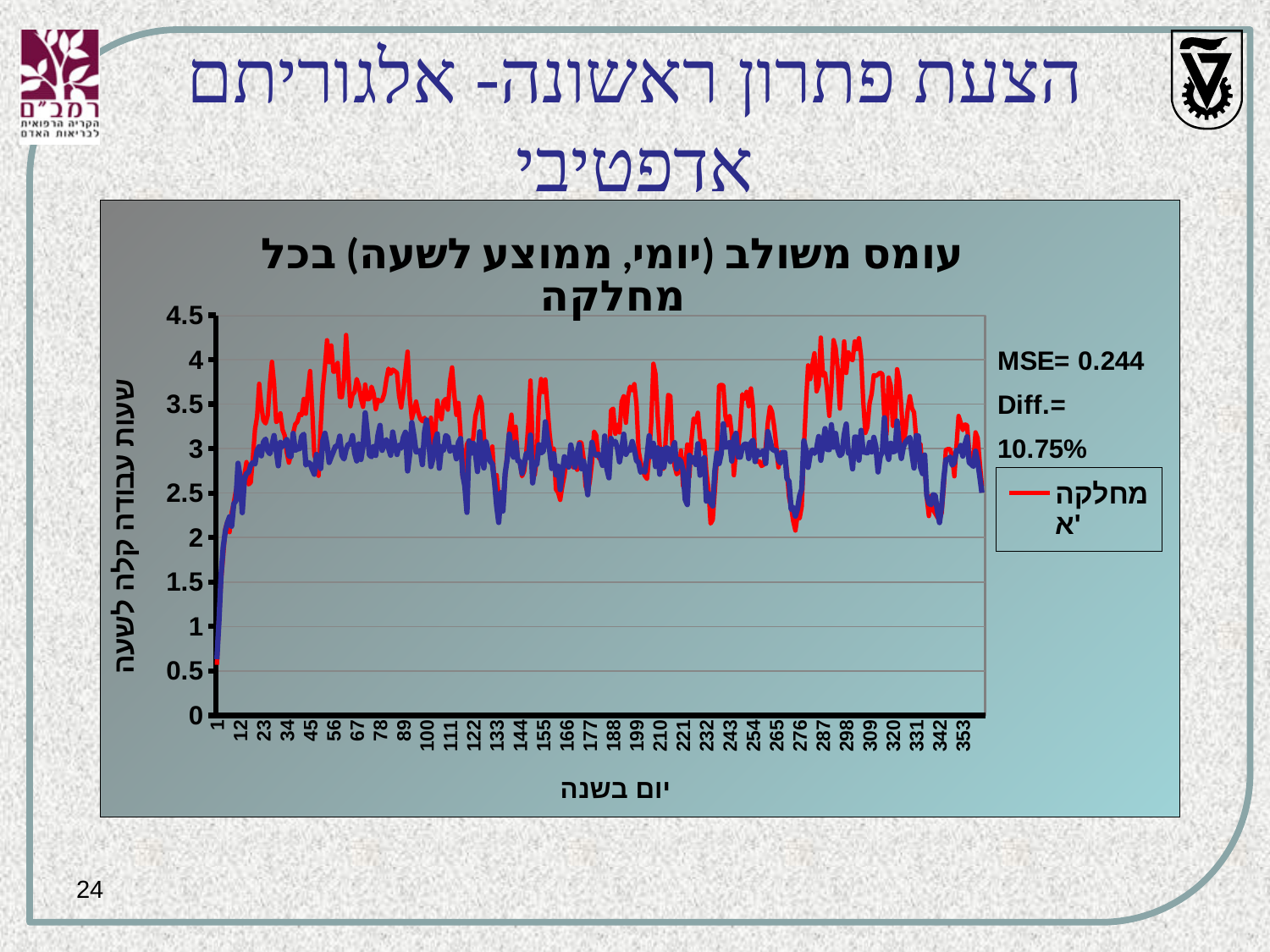
What MSE value is printed next to the chart? 0.244 Is the peak value of the red line around day 287 greater or less than 3.5? greater What is the highest value shown on the chart's y axis? 4.5 What is the name of the series shown in the chart's legend? מחלקה א' What Diff. value is printed next to the chart? 10.75% Does the red line rise or fall between day 1 and day 23? rise Around day 56, which line is higher, the red line or the blue line? the red line What is the title of the chart? עומס משולב (יומי, ממוצע לשעה) בכל מחלקה Is the value of the red line at day 1 greater or less than 1? less Is the value of the blue line around day 276 greater or less than 2.5? less How many series does the chart's legend list? 1 What kind of chart is shown on the slide? line chart